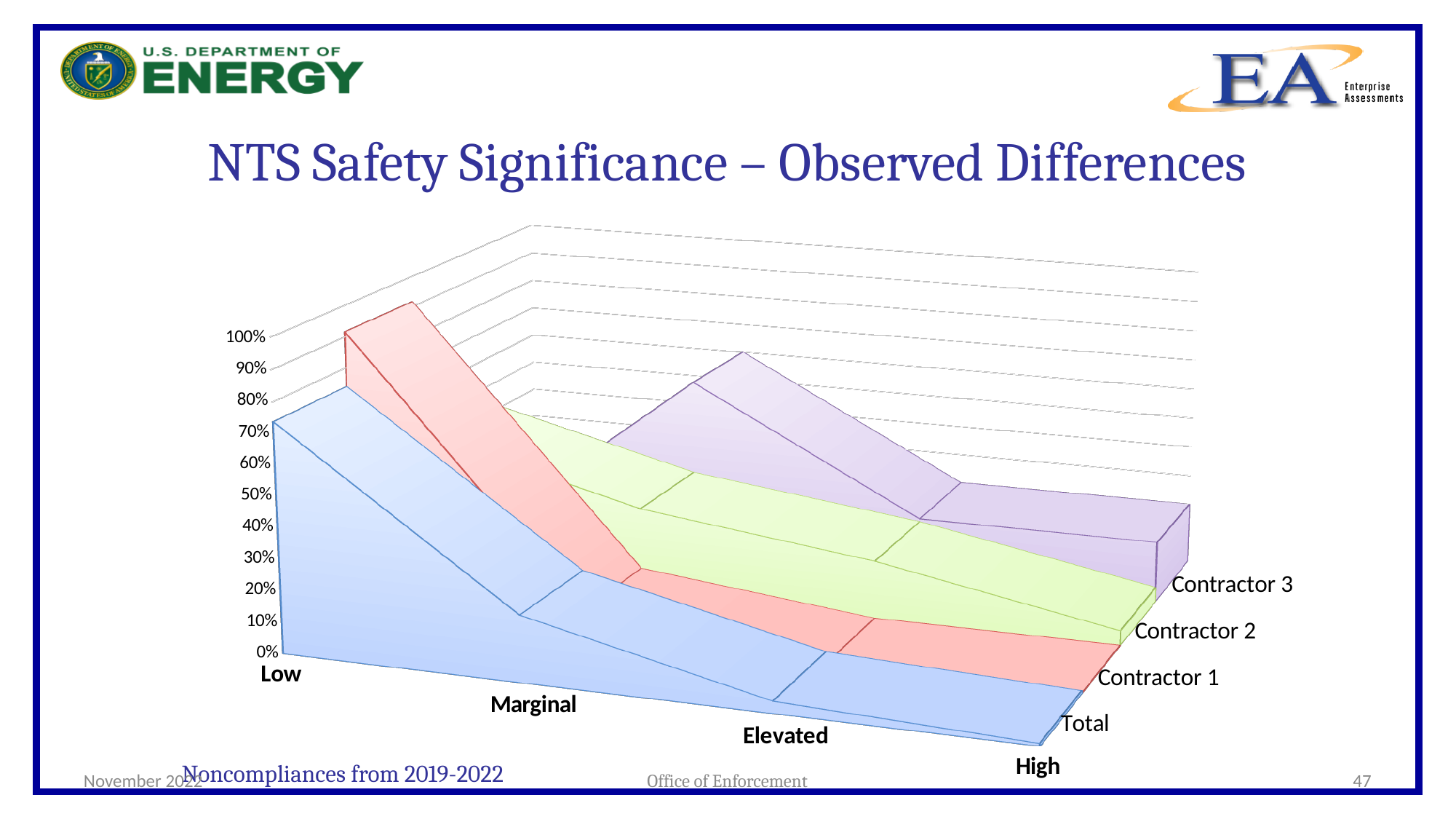
For Contractor 1, which is larger: the value for Low or the value for Elevated? Low Does the Total series rise or fall from Low to High? Fall For the Total series, which category has the highest value? Low How many safety significance categories are shown along the x axis? 4 Is the Total value for Low greater or less than 50%? greater Is the Contractor 1 value for Low greater or less than 50%? greater Is the Total value for High greater or less than 10%? less What is the title of the chart on the slide? NTS Safety Significance – Observed Differences How many data series are plotted in the chart? 4 For the Total series, which is larger: the value for Low or the value for Marginal? Low What kind of chart is shown on the slide? 3D area chart Which series are plotted in the chart? Total, Contractor 1, Contractor 2, Contractor 3